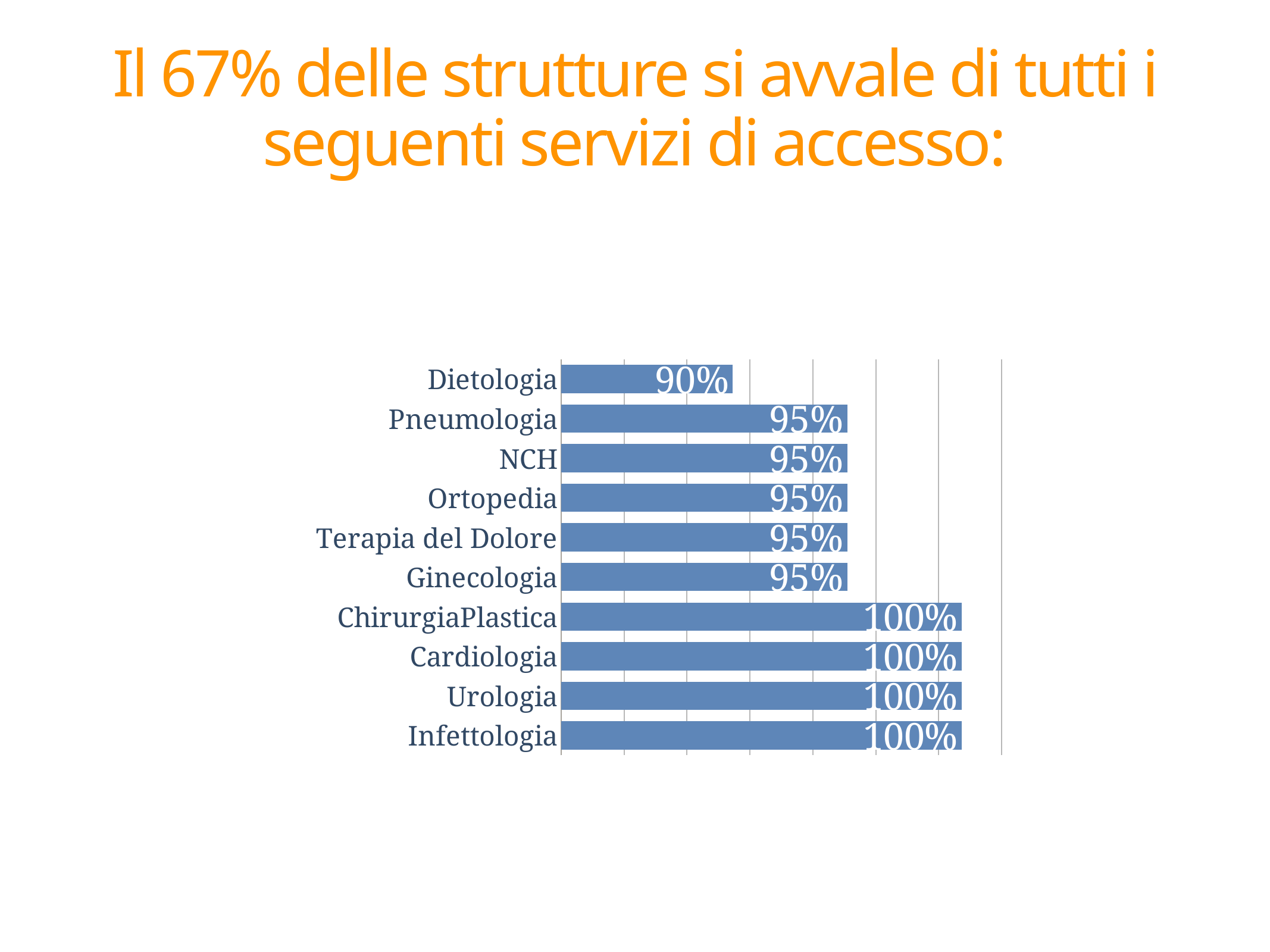
What is the difference between the values for Infettologia and Dietologia? 10% How many categories have a value of 100%? 4 Which is larger, the value for NCH or the value for ChirurgiaPlastica? ChirurgiaPlastica What kind of chart is shown on the slide? Bar chart What is the value for Pneumologia? 95% What is the value for Cardiologia? 100% Which category has the lowest value? Dietologia How many categories are shown in the chart? 10 Which is larger, the value for Ortopedia or the value for Dietologia? Ortopedia What is the value for Terapia del Dolore? 95% What is the value for Dietologia? 90% What is the difference between the values for Urologia and Ginecologia? 5%